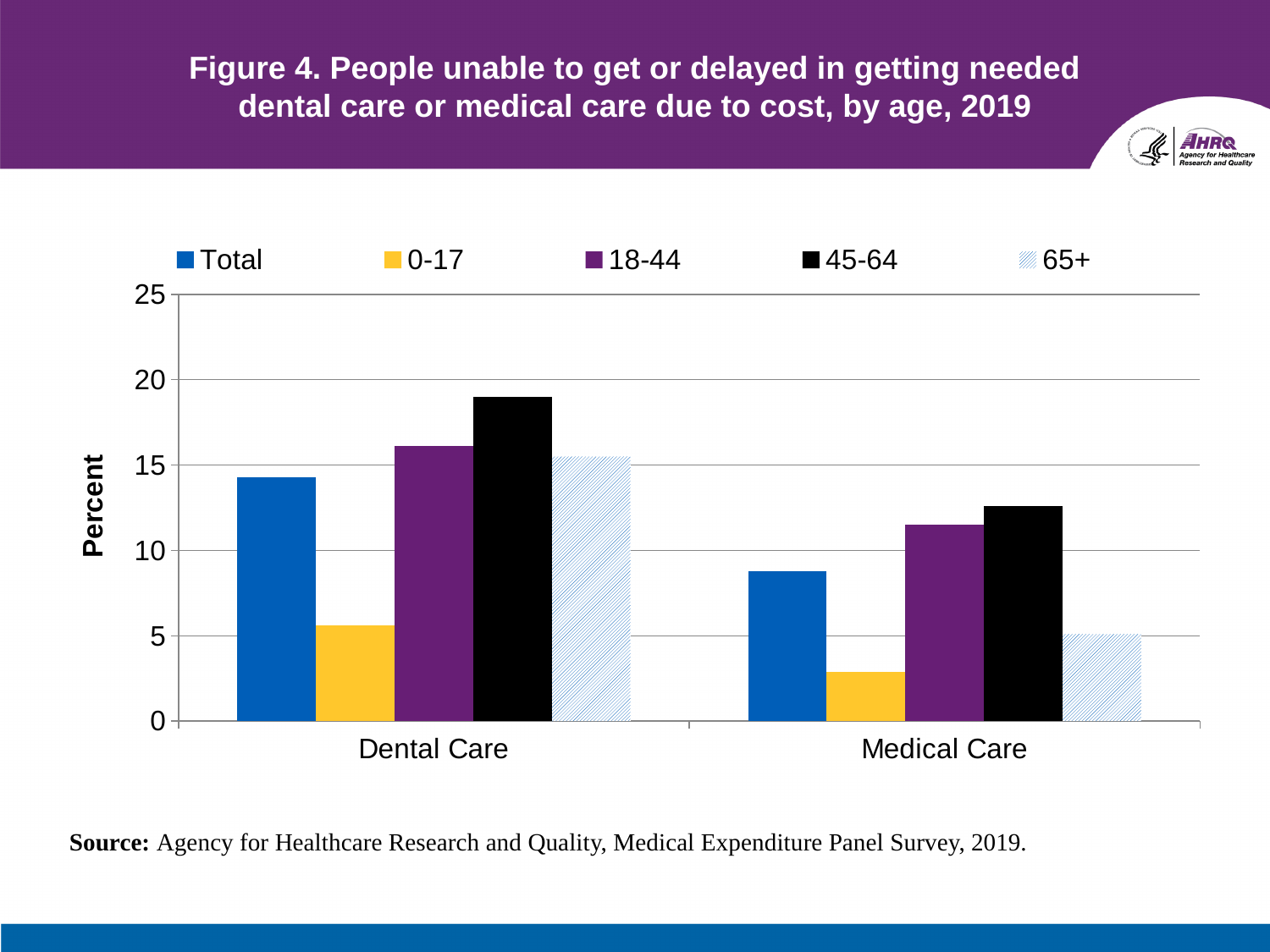
Which age group has the lowest value for Medical Care? 0-17 How many categories are shown on the x axis? 2 Is the value for 45-64 in Dental Care greater or less than 15? greater How many series does the legend list? 5 Which age group has the lowest value for Dental Care? 0-17 What is the label on the y axis? Percent Is the value for 0-17 in Medical Care greater or less than 5? less Is the value for 18-44 in Medical Care greater or less than 10? greater What kind of chart is shown on the slide? Bar chart Which age group has the highest value for Dental Care? 45-64 Which is larger, the Total value for Dental Care or the Total value for Medical Care? Dental Care